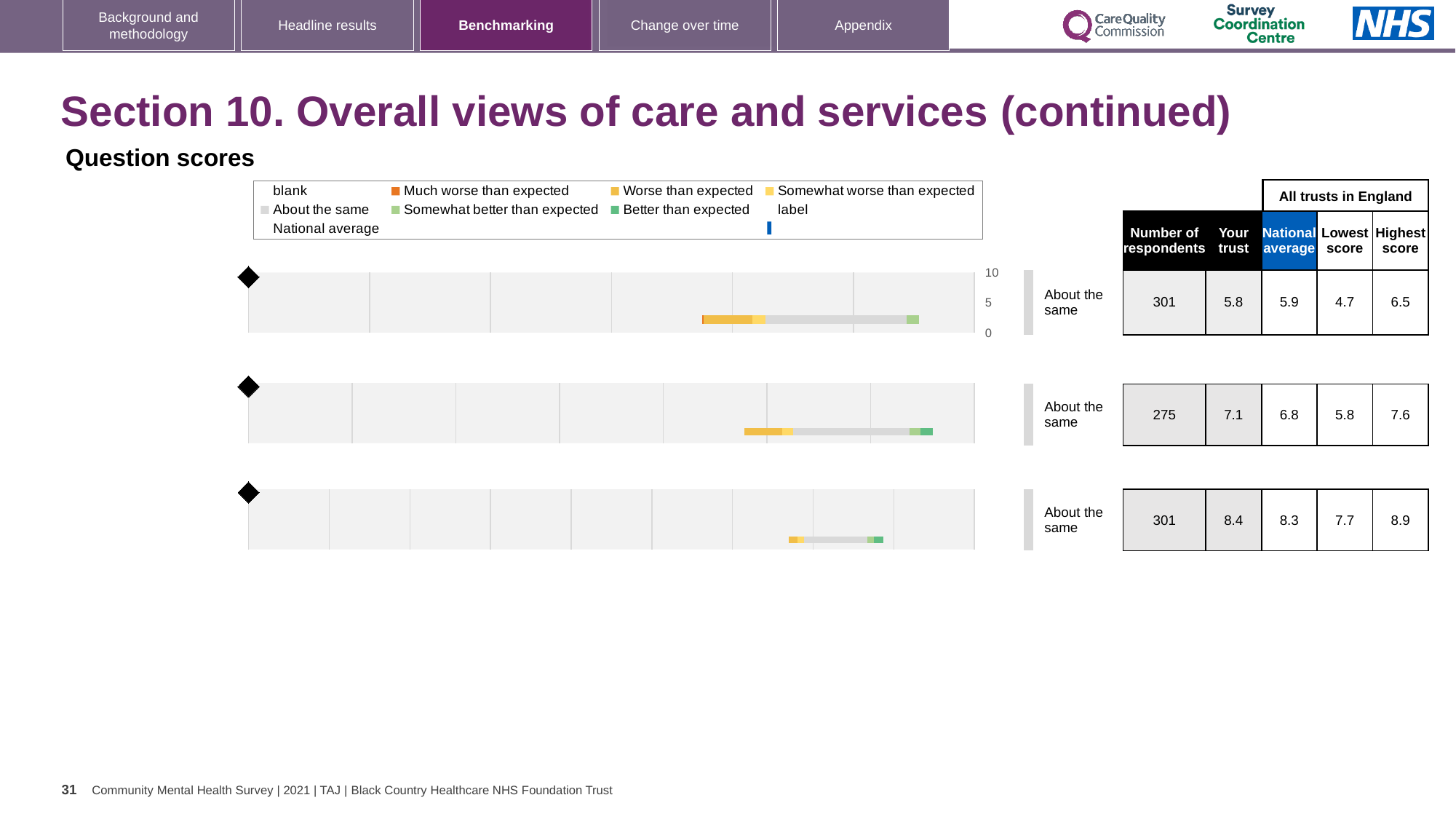
What kind of chart is used for the three benchmarking charts on this slide? bar chart What is the highest tick value shown on the axis of the top chart? 10 What benchmark category label is shown to the right of the top chart? About the same How many entries does the shared legend above the charts list? 9 Which colour does the legend use for 'Much worse than expected'? orange How many separate benchmarking charts are shown on the slide? 3